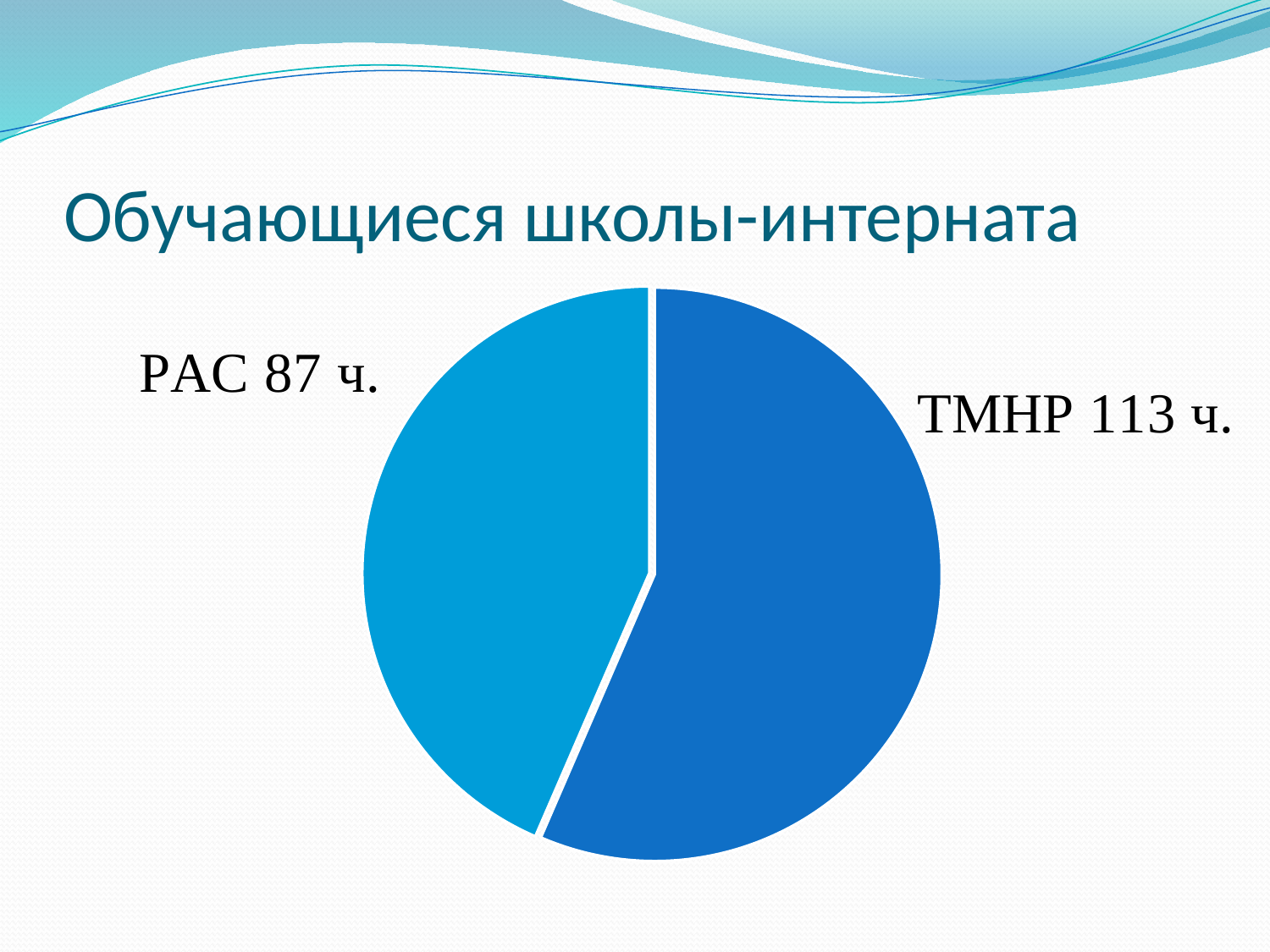
Which is larger, the value for ТМНР or the value for РАС? ТМНР What is the total of the two values shown in the pie chart? 200 ч. What is the difference between the value for ТМНР and the value for РАС? 26 ч. What share of the pie does РАС represent? 43.5% What share of the pie does ТМНР represent? 56.5% Which category has the smallest slice of the pie? РАС What is the title of the slide containing the pie chart? Обучающиеся школы-интерната How many slices does the pie chart have? 2 What kind of chart is shown on the slide? Pie chart What is the value shown for ТМНР? 113 ч. Which category has the largest slice of the pie? ТМНР What is the value shown for РАС? 87 ч.